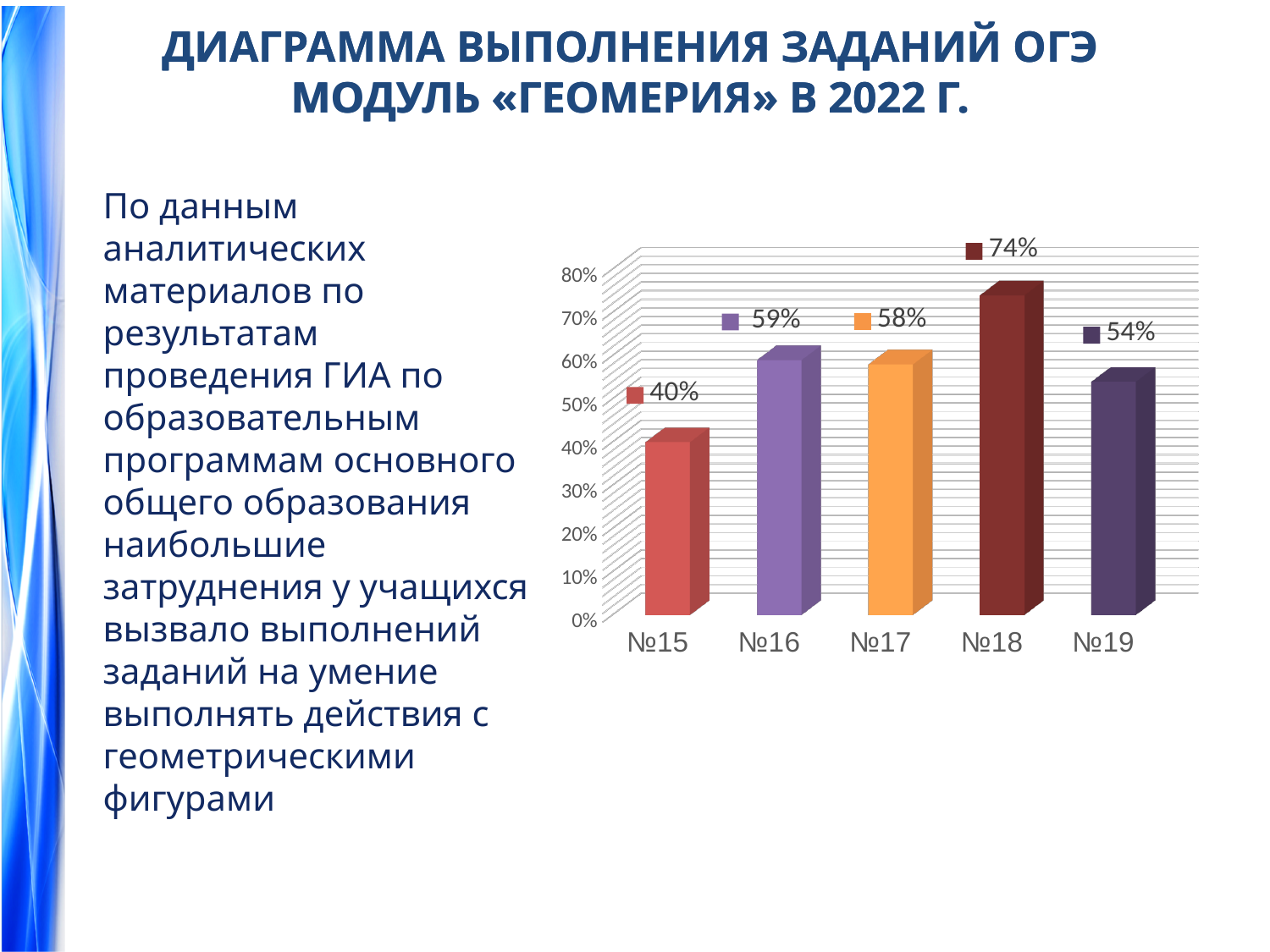
What is the difference between the values for №16 and №19? 5% What is the value for task №19? 54% Is the value for №18 greater or less than 70%? greater Which task has the lowest value? №15 What is the difference between the values for №18 and №15? 34% Which is larger, the value for №17 or the value for №19? №17 What is the value for task №18? 74% Which task has the highest value? №18 How many tasks are shown on the chart? 5 What is the value for task №16? 59% What is the value for task №15? 40% What kind of chart is shown on the slide? bar chart